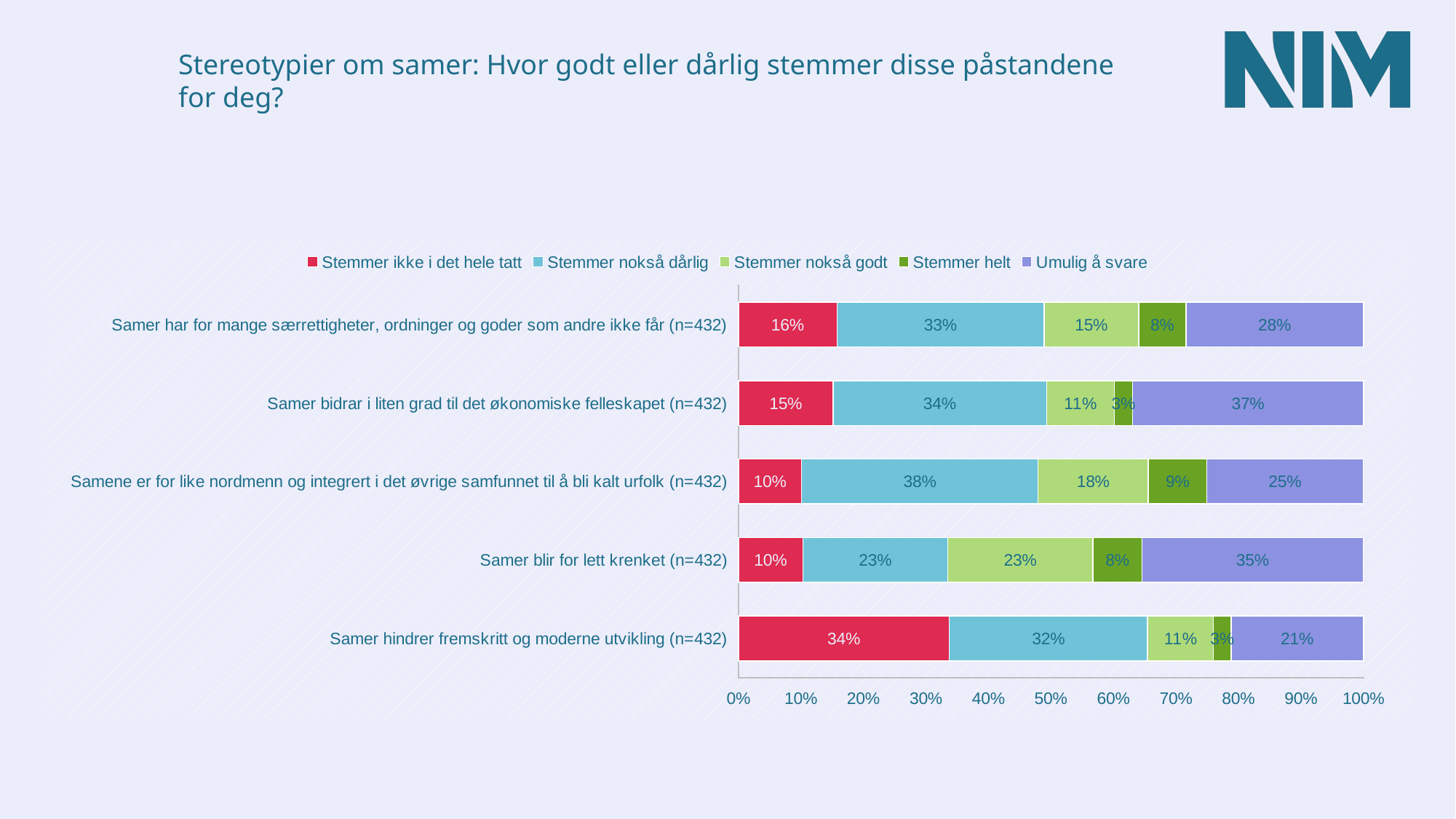
What percentage answered "Umulig å svare" for the statement "Samer bidrar i liten grad til det økonomiske felleskapet"? 37% How many response categories does the legend list? 5 Which statement has the lowest "Umulig å svare" share? Samer hindrer fremskritt og moderne utvikling What is the "Stemmer nokså godt" value for "Samer blir for lett krenket"? 23% Which has a larger "Umulig å svare" share: "Samer bidrar i liten grad til det økonomiske felleskapet" or "Samer har for mange særrettigheter, ordninger og goder som andre ikke får"? Samer bidrar i liten grad til det økonomiske felleskapet Which response category is shown in red in the legend? Stemmer ikke i det hele tatt What type of chart is shown on the slide? Stacked bar chart How many statements (bars) are shown in the chart? 5 Which statement has the highest "Stemmer nokså dårlig" share? Samene er for like nordmenn og integrert i det øvrige samfunnet til å bli kalt urfolk What is the "Stemmer ikke i det hele tatt" value for "Samer hindrer fremskritt og moderne utvikling"? 34% What is the difference in the "Stemmer nokså dårlig" share between "Samene er for like nordmenn..." and "Samer blir for lett krenket"? 15 percentage points Which statement has the highest "Stemmer ikke i det hele tatt" share? Samer hindrer fremskritt og moderne utvikling